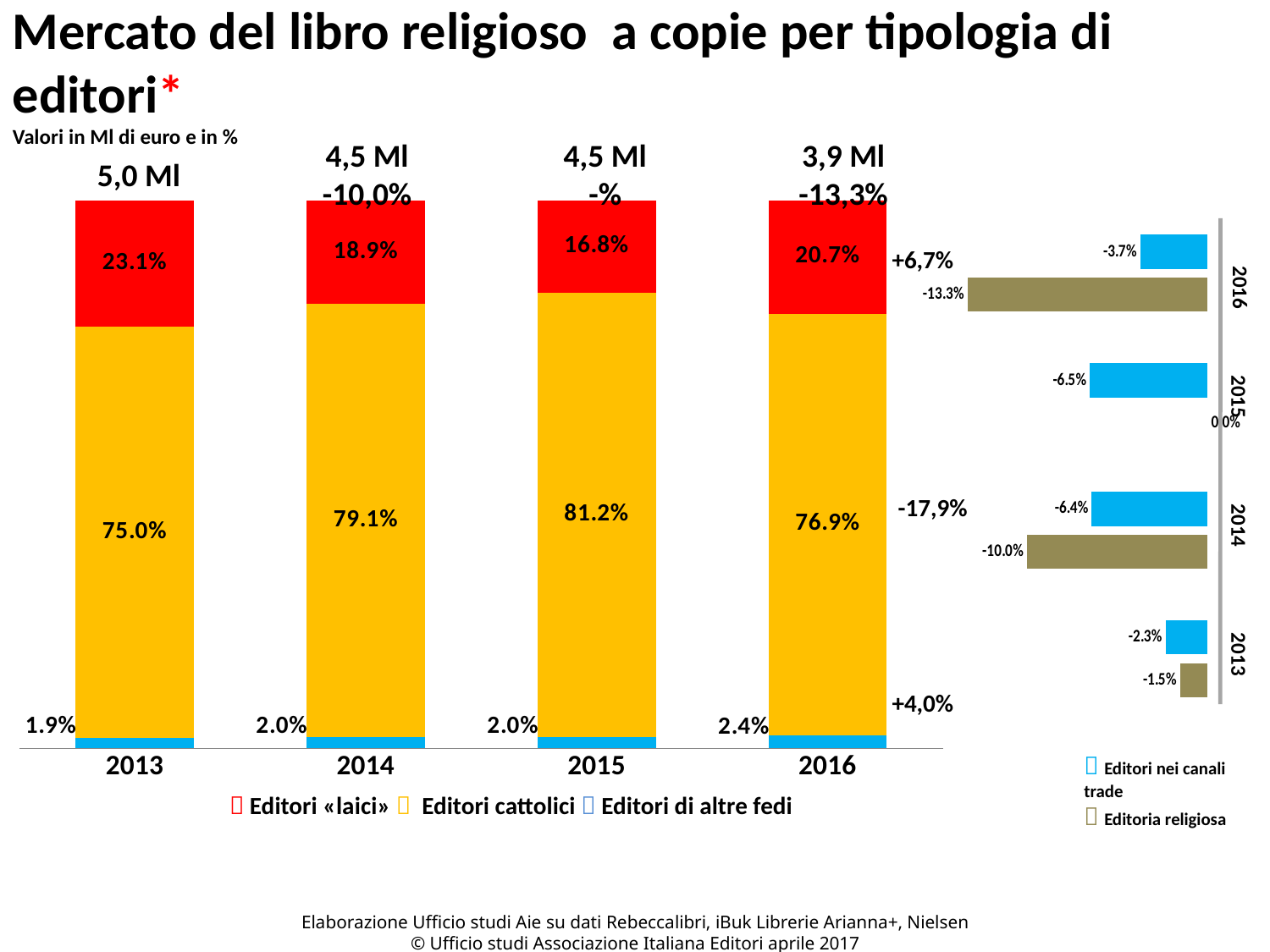
How many series does the legend of the stacked bar chart on the left list? 3 In the stacked bar chart on the left, does the share for Editori di altre fedi rise or fall from 2013 to 2016? Rise In the horizontal bar chart on the right, what is the value for Editoria religiosa in 2014? -10.0% In the stacked bar chart on the left, what is the value for Editori «laici» in 2013? 23.1% In the stacked bar chart on the left, what is the difference between the Editori cattolici share in 2015 and in 2013? 6.2 percentage points In the stacked bar chart on the left, which year has the highest share for Editori cattolici? 2015 How many years are shown on the x axis of the stacked bar chart on the left? 4 In the stacked bar chart on the left, which year has the lowest share for Editori «laici»? 2015 In the stacked bar chart on the left, is the Editori «laici» share larger in 2014 or in 2016? 2016 In the stacked bar chart on the left, what is the value for Editori cattolici in 2015? 81.2% In the horizontal bar chart on the right, what is the value for Editori nei canali trade in 2015? -6.5% What kind of chart is the chart on the right of the slide? Bar chart